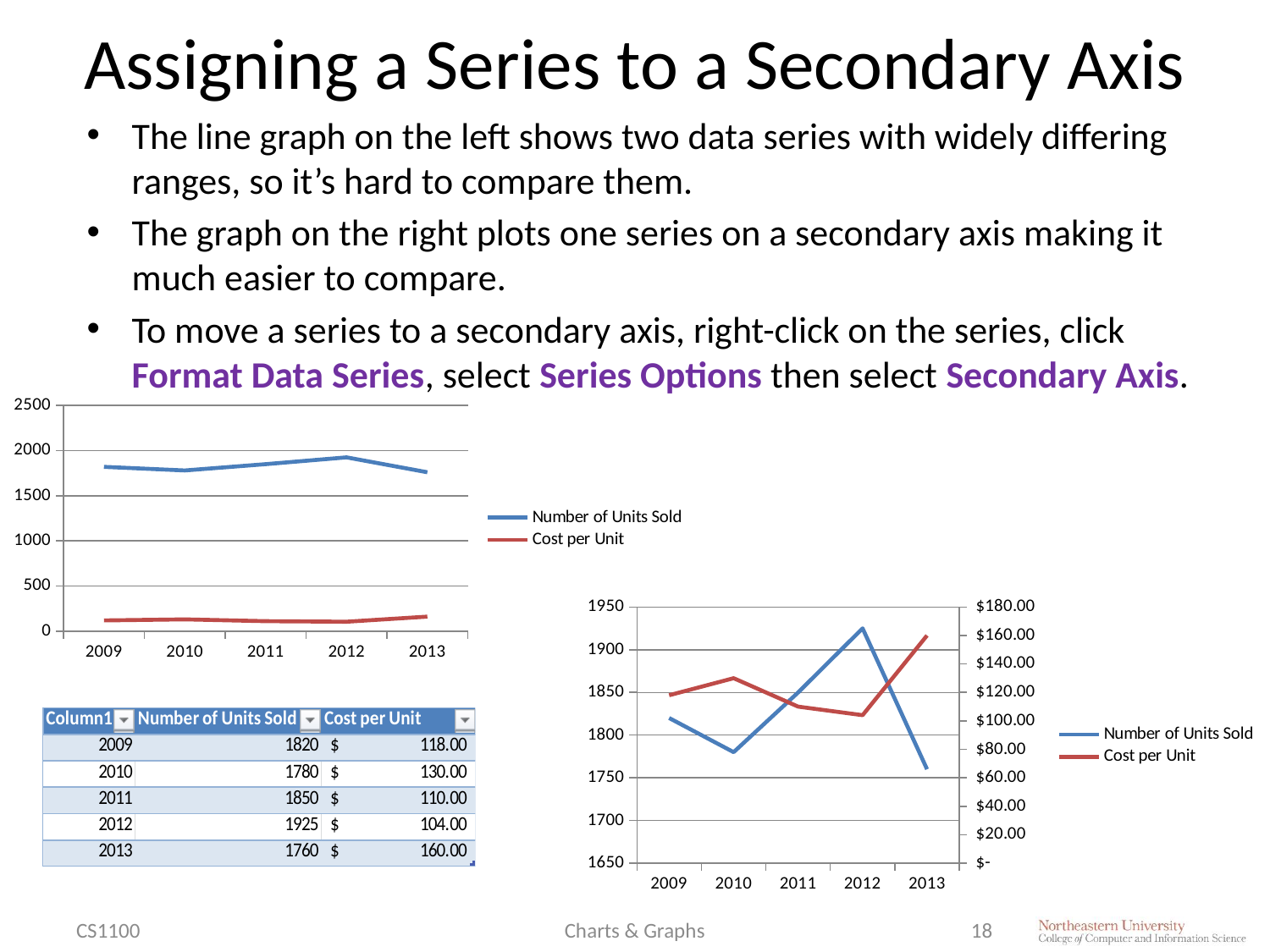
Using the values in the table, what is the difference in Number of Units Sold between 2012 and 2013? 165 In the right-hand chart, which year has the highest Number of Units Sold? 2012 In the right-hand chart, which series is drawn in red? Cost per Unit How many series does the legend of the right-hand chart list? 2 According to the table on the slide, what is the Number of Units Sold in 2012? 1925 In the right-hand chart, is the Number of Units Sold in 2010 greater or less than 1800? less In the right-hand chart, which year has the lowest Number of Units Sold? 2013 What type of chart is the chart on the left of the slide? line chart In the right-hand chart, which year has the lowest Cost per Unit? 2012 According to the table on the slide, what is the Cost per Unit in 2013? $ 160.00 In the right-hand chart, is the Cost per Unit in 2013 greater or less than $140.00? greater How many years are plotted along the x axis of the right-hand chart? 5